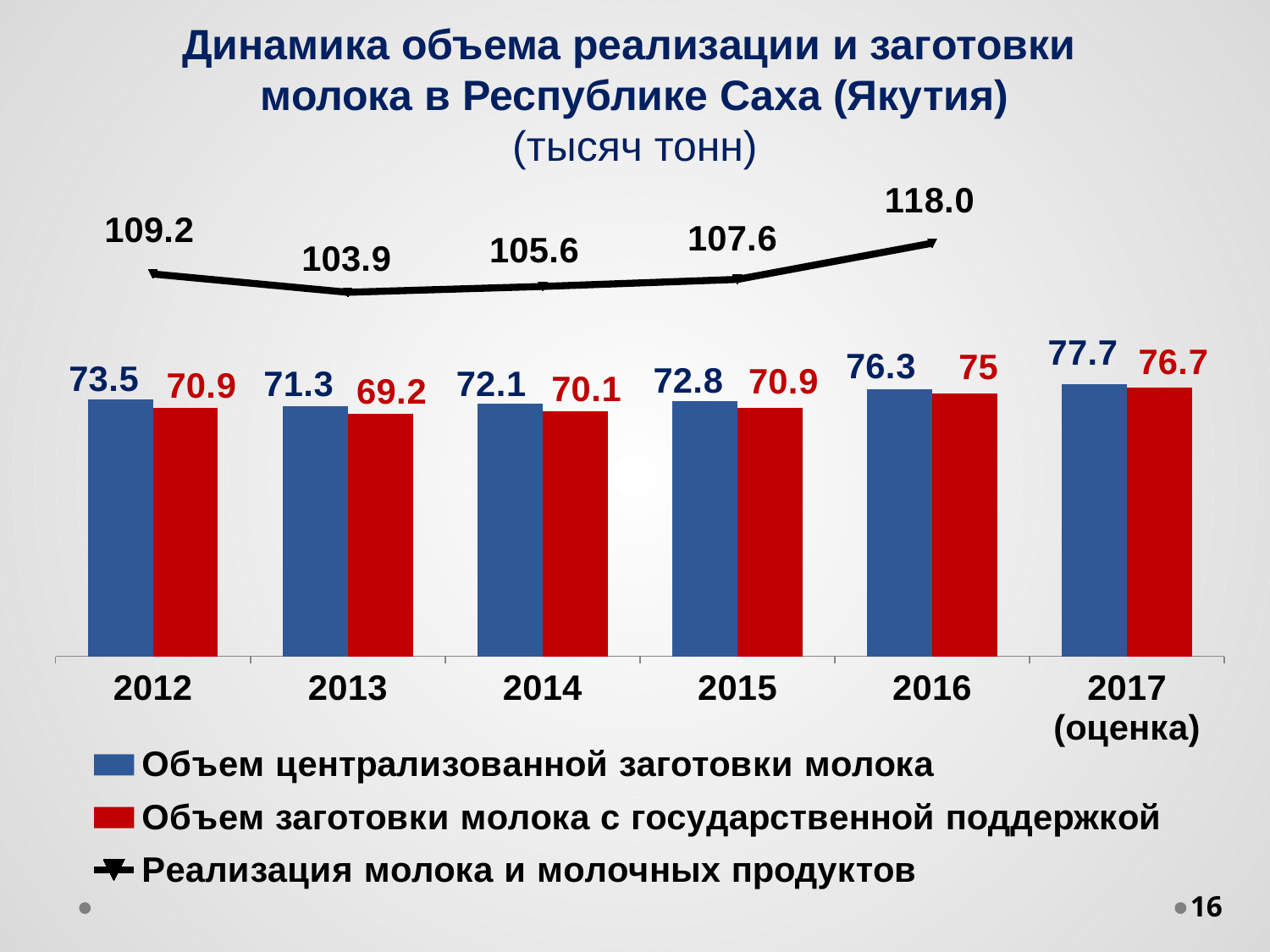
What is the value of 'Реализация молока и молочных продуктов' for 2016? 118.0 In which year is 'Объем централизованной заготовки молока' highest? 2017 (оценка) How many years are shown on the x axis? 6 Which is larger in 2015: 'Объем централизованной заготовки молока' or 'Объем заготовки молока с государственной поддержкой'? Объем централизованной заготовки молока What is the value of 'Объем централизованной заготовки молока' for 2012? 73.5 How many series does the legend list? 3 In which year is 'Объем заготовки молока с государственной поддержкой' lowest? 2013 What kind of chart is shown on the slide? Combined bar and line chart What unit is given in the chart title? тысяч тонн Does 'Объем заготовки молока с государственной поддержкой' rise or fall from 2013 to 2017? Rise What is the difference between 'Объем централизованной заготовки молока' and 'Объем заготовки молока с государственной поддержкой' in 2016? 1.3 What is the value of 'Объем заготовки молока с государственной поддержкой' for 2013? 69.2